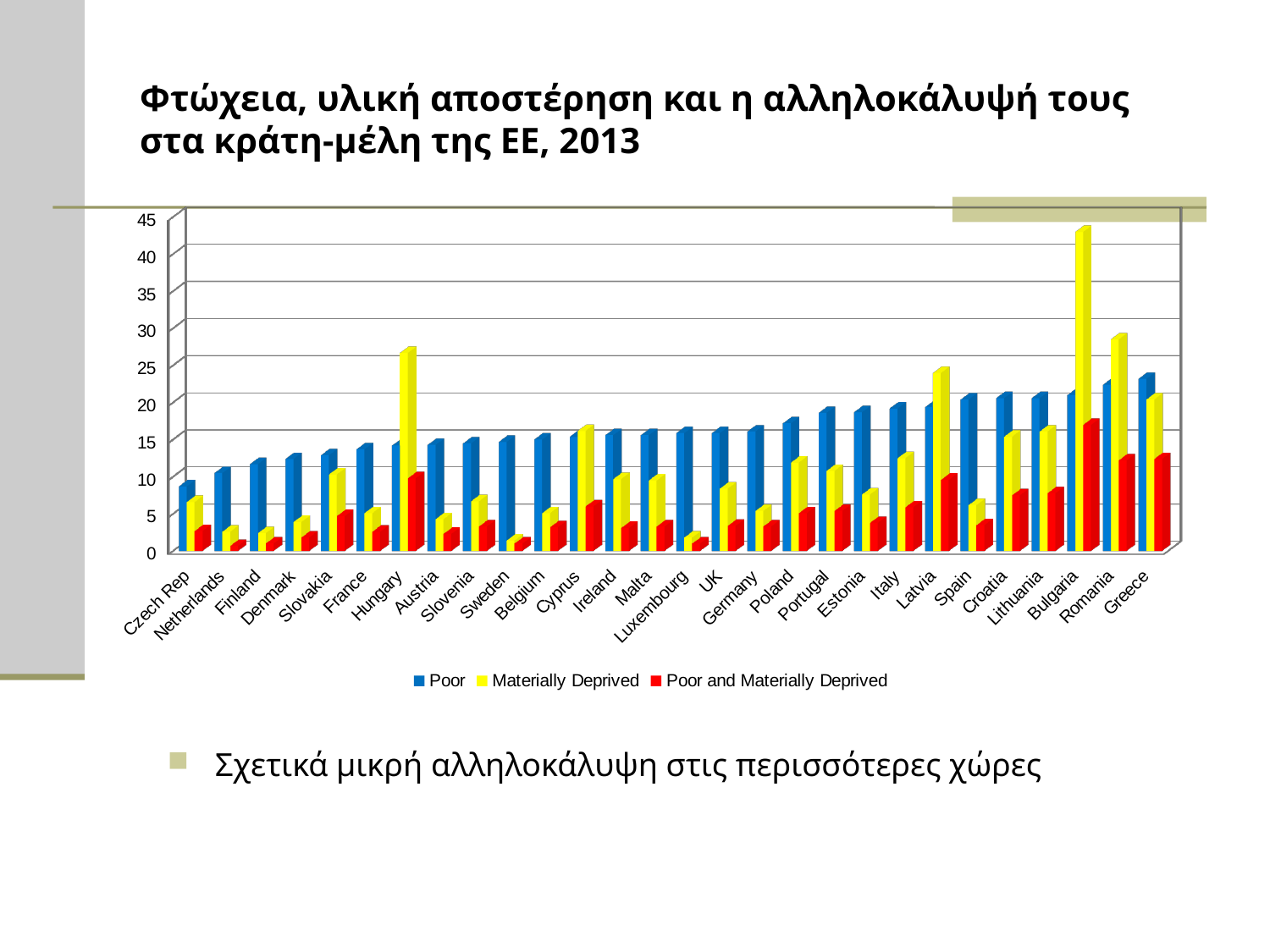
How many countries are shown on the x axis of the chart? 28 Which country has the highest value for the Poor and Materially Deprived series? Bulgaria Which country has the highest value for the Poor series? Greece Is the Materially Deprived value for Bulgaria greater or less than 40? greater What kind of chart is shown on the slide? Bar chart Which country has the lowest value for the Poor series? Czech Rep Do the values of the Poor series generally rise or fall from left to right along the x axis? Rise Is the Poor value for Czech Rep greater or less than 10? less How many series does the legend list? 3 Which country has the highest value for the Materially Deprived series? Bulgaria For Hungary, which is larger: the Poor value or the Materially Deprived value? Materially Deprived Is the Materially Deprived value for Romania greater or less than 25? greater